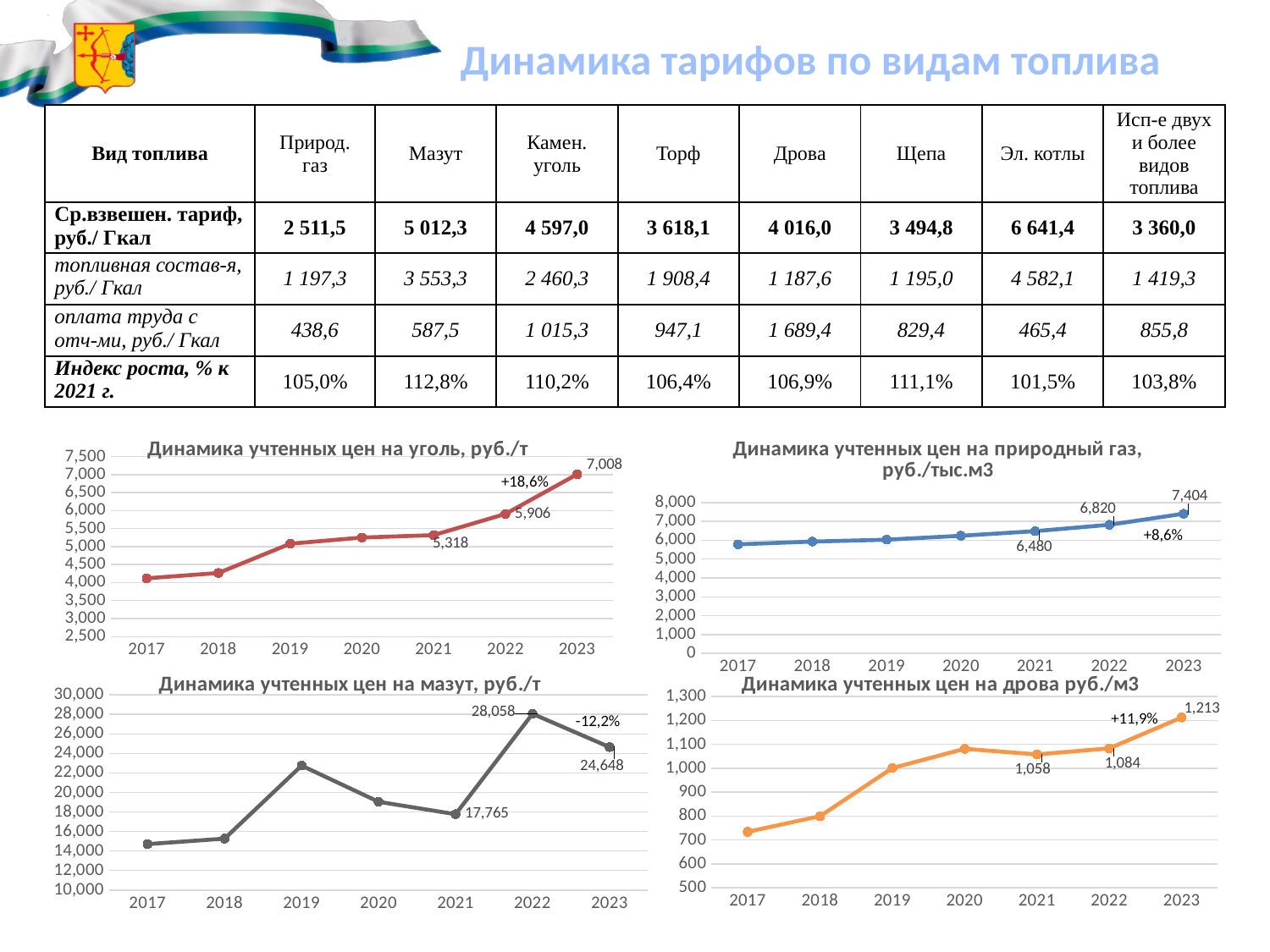
In the chart 'Динамика учтенных цен на дрова руб./м3', what is the value for 2023? 1,213 In the chart 'Динамика учтенных цен на уголь, руб./т', what is the difference between the values for 2023 and 2022? 1,102 What kind of chart is 'Динамика учтенных цен на мазут, руб./т'? line chart In the chart 'Динамика учтенных цен на уголь, руб./т', is the value for 2017 greater or less than 4,500? less In the chart 'Динамика учтенных цен на природный газ, руб./тыс.м3', what is the value for 2021? 6,480 In the chart 'Динамика учтенных цен на уголь, руб./т', what is the value for 2023? 7,008 How many years are plotted in the chart 'Динамика учтенных цен на дрова руб./м3'? 7 In the chart 'Динамика учтенных цен на мазут, руб./т', what is the difference between the values for 2022 and 2023? 3,410 In the chart 'Динамика учтенных цен на мазут, руб./т', what is the value for 2022? 28,058 In the chart 'Динамика учтенных цен на мазут, руб./т', which year has the highest value? 2022 In the chart 'Динамика учтенных цен на природный газ, руб./тыс.м3', which is larger, the value for 2022 or the value for 2023? 2023 In the chart 'Динамика учтенных цен на дрова руб./м3', which year has the lowest value? 2017